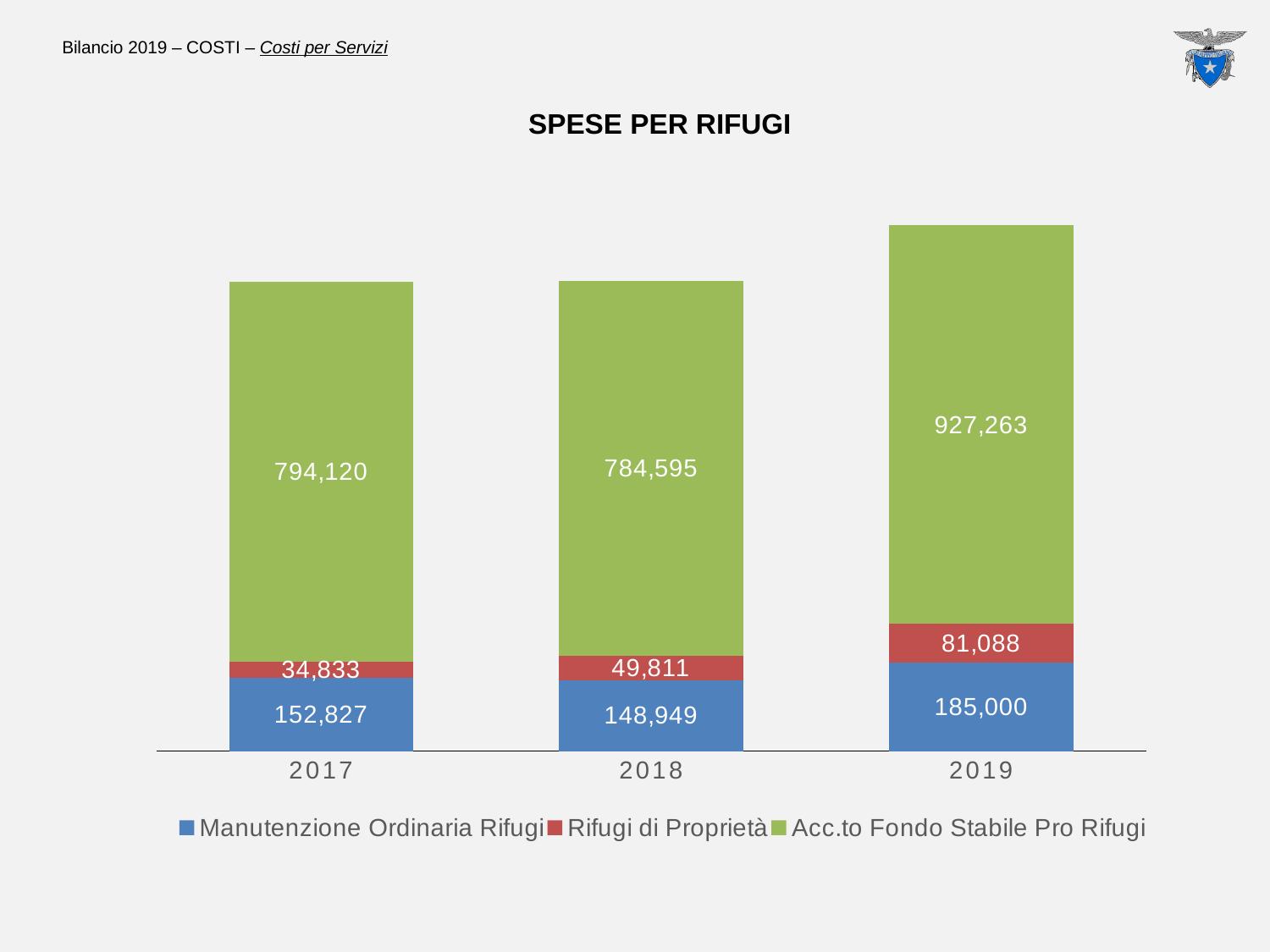
How many years are shown on the x axis? 3 What is the value for Rifugi di Proprietà in 2018? 49,811 What is the value for Manutenzione Ordinaria Rifugi in 2017? 152,827 What is the total of the stacked bar for 2019? 1,193,351 What is the value for Acc.to Fondo Stabile Pro Rifugi in 2019? 927,263 Which is larger: Manutenzione Ordinaria Rifugi in 2017 or in 2018? 2017 In which year is the Acc.to Fondo Stabile Pro Rifugi value lowest? 2018 What is the total of the stacked bar for 2017? 981,780 What is the difference between the Rifugi di Proprietà values for 2019 and 2017? 46,255 How many series does the legend list? 3 What is the difference between the Acc.to Fondo Stabile Pro Rifugi values for 2019 and 2018? 142,668 In which year is the Rifugi di Proprietà value highest? 2019